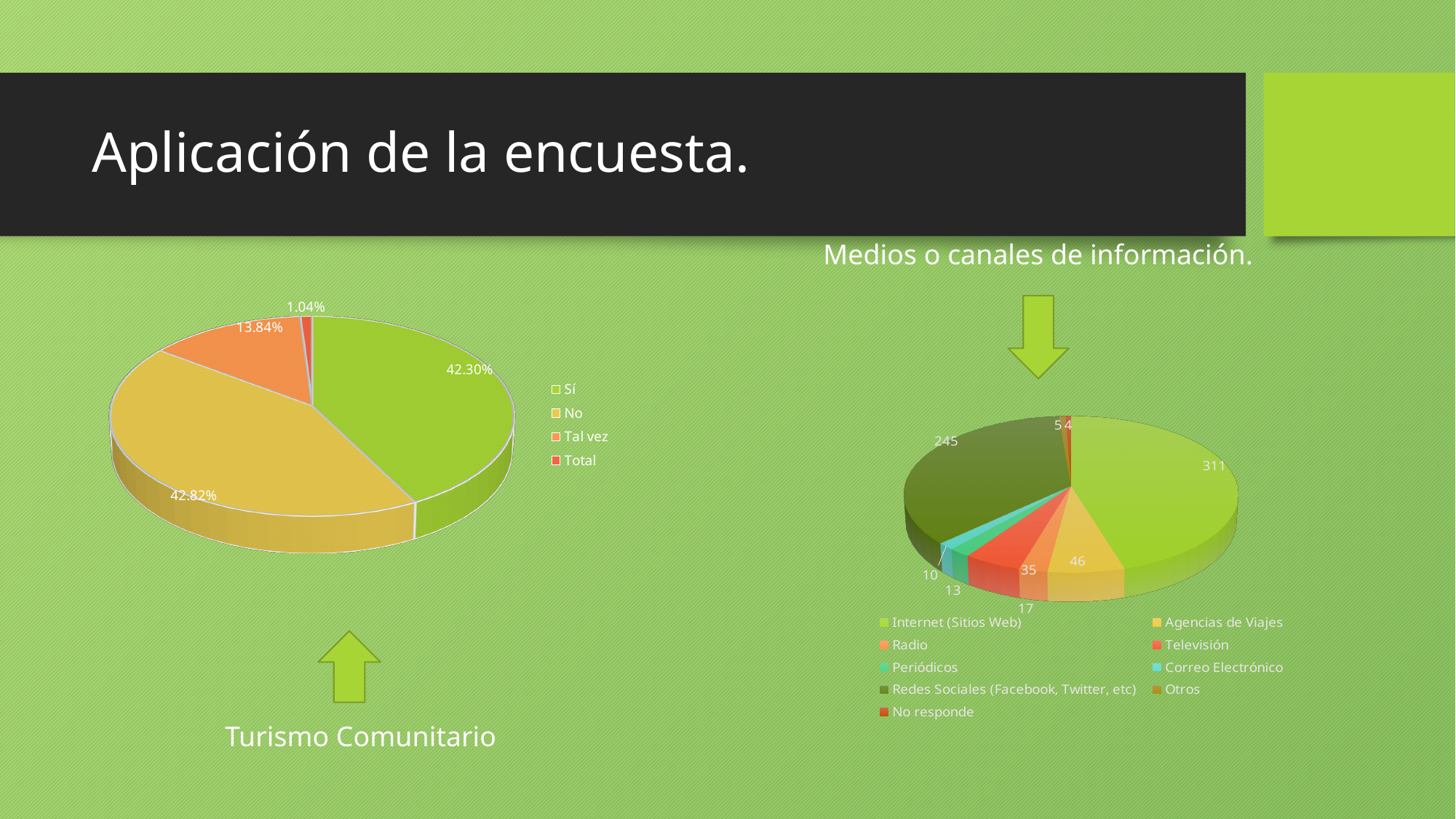
In the Turismo Comunitario pie chart, what percentage is shown for 'Tal vez'? 13.84% In the Medios o canales de información chart, what value is shown for Internet (Sitios Web)? 311 In the Turismo Comunitario pie chart, what percentage is shown for 'Sí'? 42.30% In the Turismo Comunitario pie chart, which category has the smallest slice? Total What type of chart is used for Medios o canales de información? Pie chart In the Medios o canales de información chart, what value is shown for Redes Sociales (Facebook, Twitter, etc)? 245 In the Medios o canales de información chart, which category has the largest slice? Internet (Sitios Web) In the Turismo Comunitario pie chart, how many entries does the legend list? 4 In the Medios o canales de información chart, what value is shown for Agencias de Viajes? 46 In the Turismo Comunitario pie chart, what percentage is shown for the 'No' slice? 42.82% In the Medios o canales de información chart, what is the difference between the Internet (Sitios Web) value and the Redes Sociales value? 66 In the Medios o canales de información chart, which is larger, Televisión or Radio? Televisión